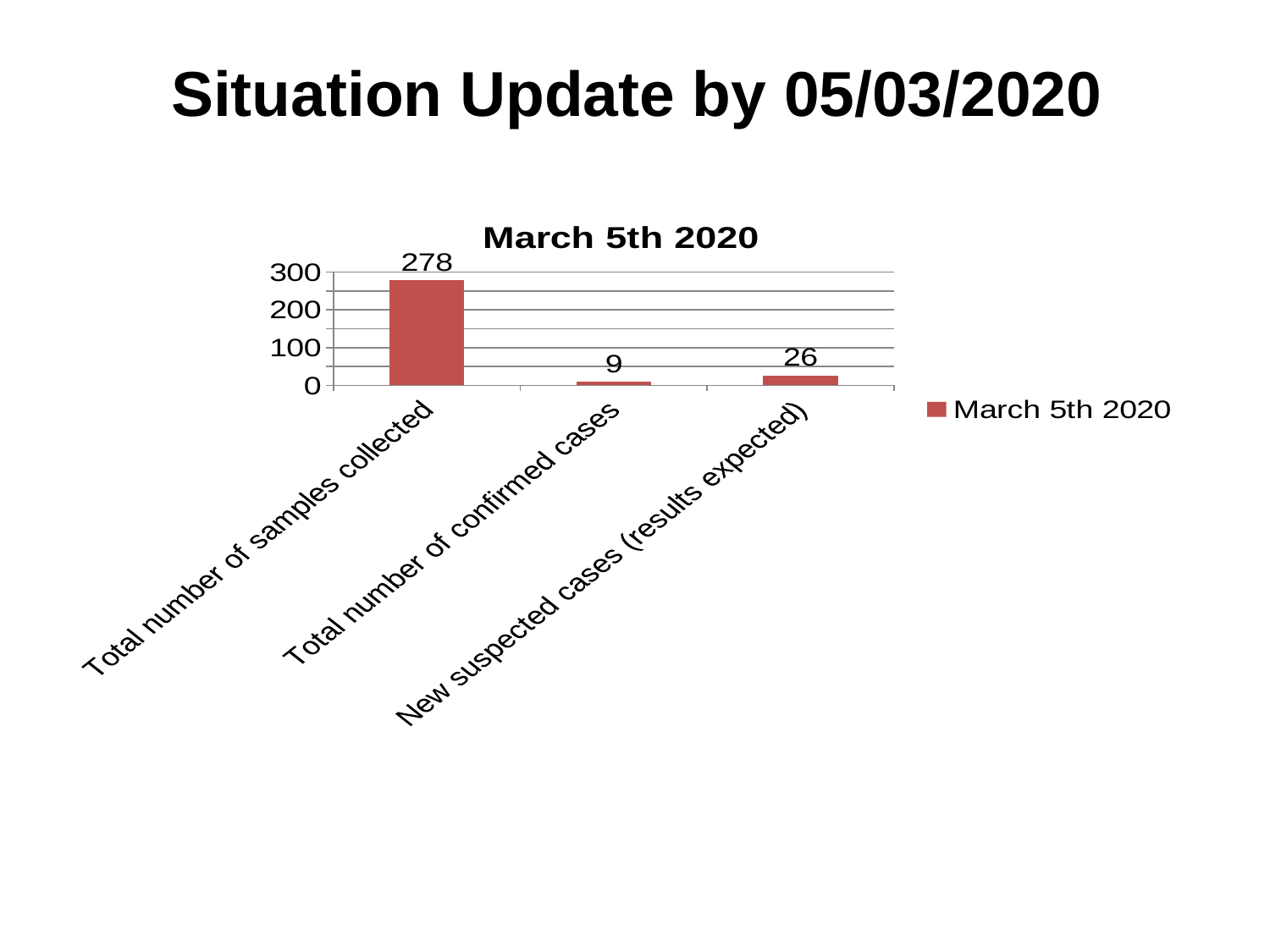
What is the difference between Total number of samples collected and New suspected cases (results expected)? 252 Which category has the lowest value? Total number of confirmed cases What is the difference between New suspected cases (results expected) and Total number of confirmed cases? 17 Which is larger, New suspected cases (results expected) or Total number of confirmed cases? New suspected cases (results expected) How many categories are shown on the chart? 3 What kind of chart is shown on the slide? Bar chart What is the title of the chart? March 5th 2020 What is the value for Total number of confirmed cases? 9 What is the value for Total number of samples collected? 278 Which category has the highest value? Total number of samples collected What is the value for New suspected cases (results expected)? 26 Is the value for Total number of samples collected greater or less than 200? greater